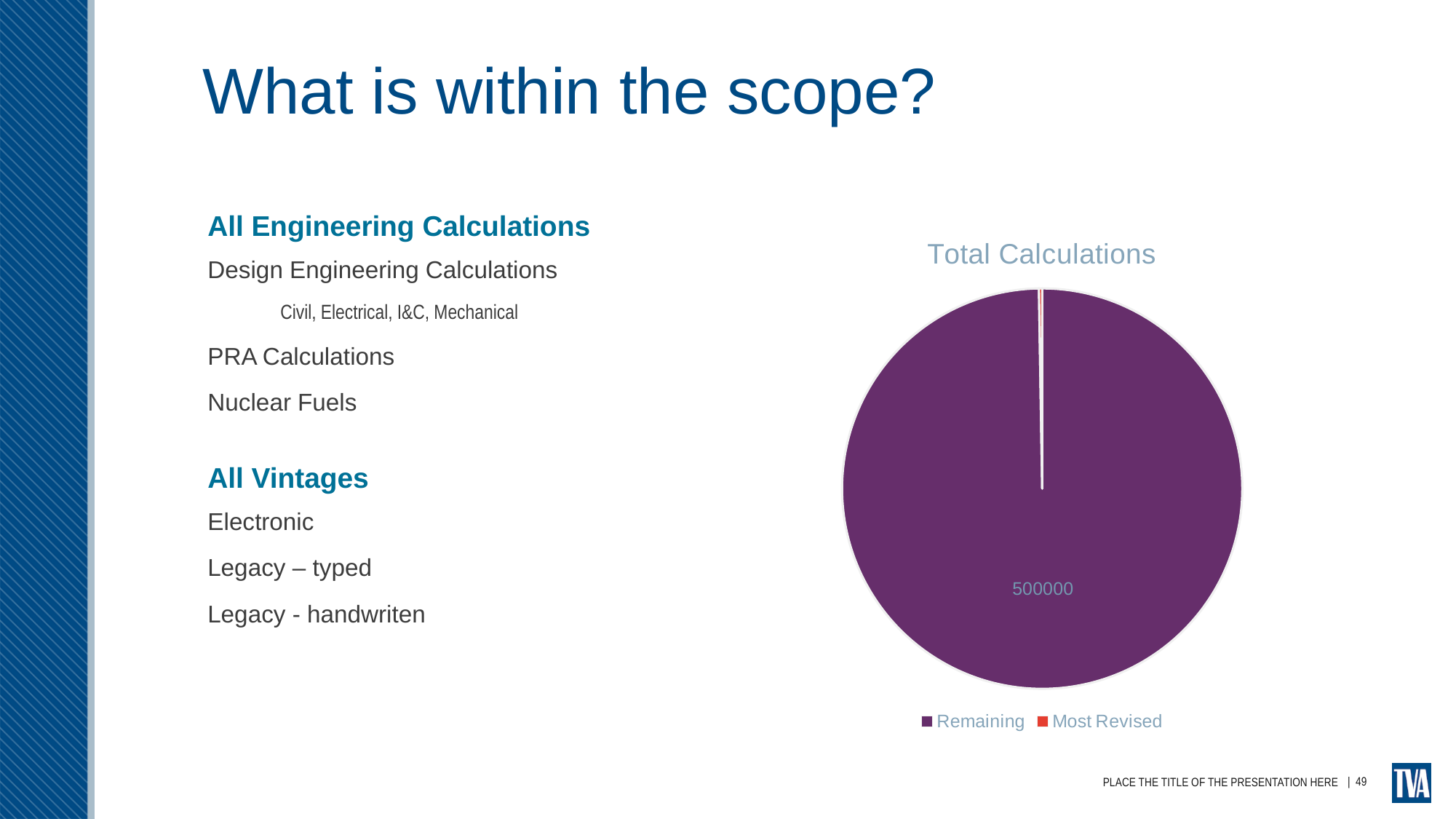
How many entries does the legend of the pie chart list? 2 What is the title of the chart? Total Calculations What value is printed on the Remaining slice of the pie chart? 500000 Which slice of the pie chart is the smallest? Most Revised Which slice of the pie chart is the largest? Remaining What colour is the Remaining slice in the pie chart? purple What kind of chart is shown on the slide? pie chart How many slices does the pie chart have? 2 Which is larger in the pie chart, Remaining or Most Revised? Remaining